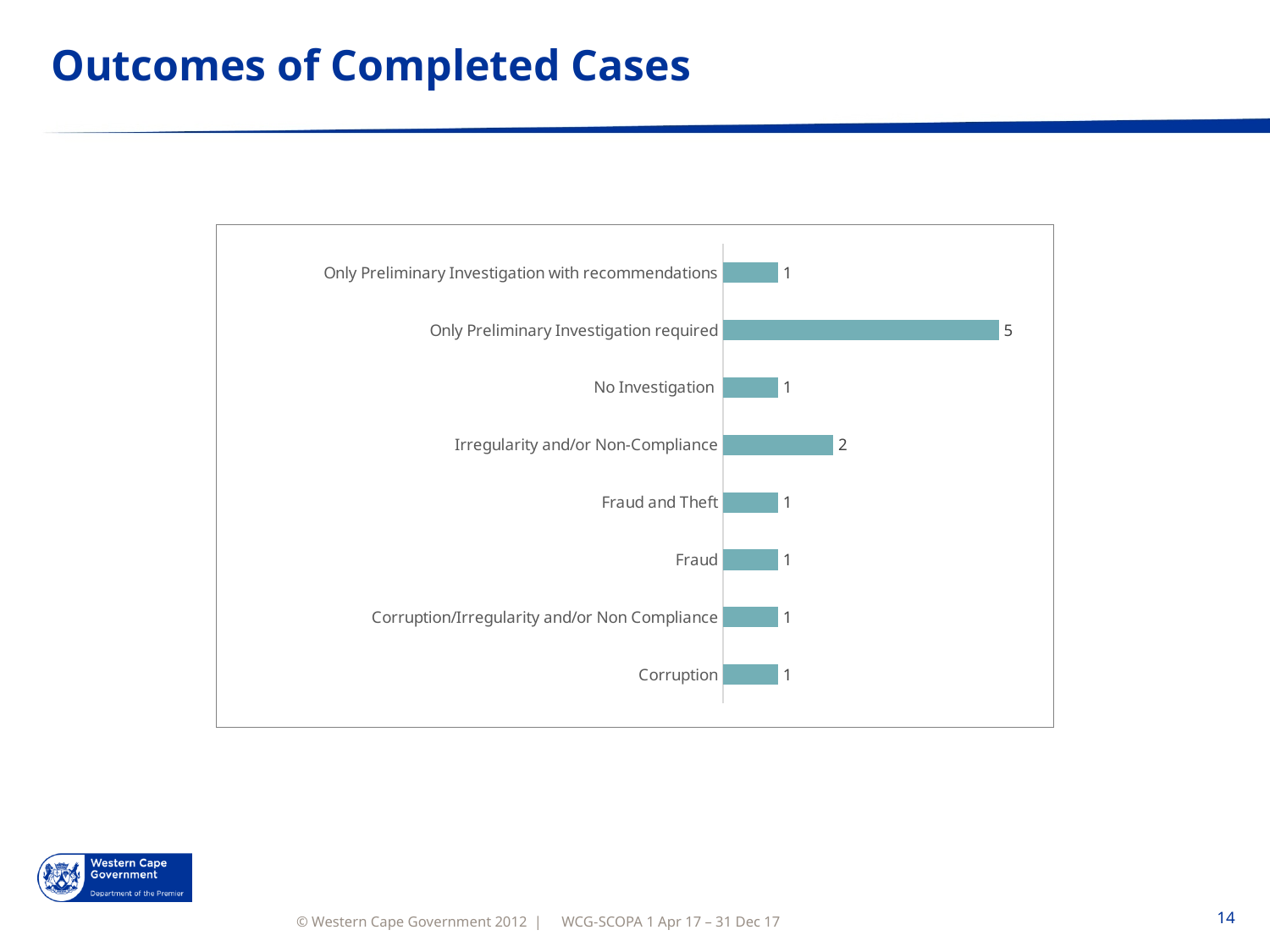
Which category has the highest value? Only Preliminary Investigation required Which is larger, the value for Only Preliminary Investigation required or the value for Fraud and Theft? Only Preliminary Investigation required What kind of chart is shown on the slide? Bar chart Which is larger, the value for Irregularity and/or Non-Compliance or the value for Corruption? Irregularity and/or Non-Compliance What is the value for Irregularity and/or Non-Compliance? 2 What is the value for Corruption? 1 What is the difference between the values for Irregularity and/or Non-Compliance and Fraud? 1 What is the title of the slide containing the chart? Outcomes of Completed Cases What is the value for Only Preliminary Investigation required? 5 What is the value for No Investigation? 1 What is the difference between the values for Only Preliminary Investigation required and Irregularity and/or Non-Compliance? 3 How many categories are shown in the chart? 8